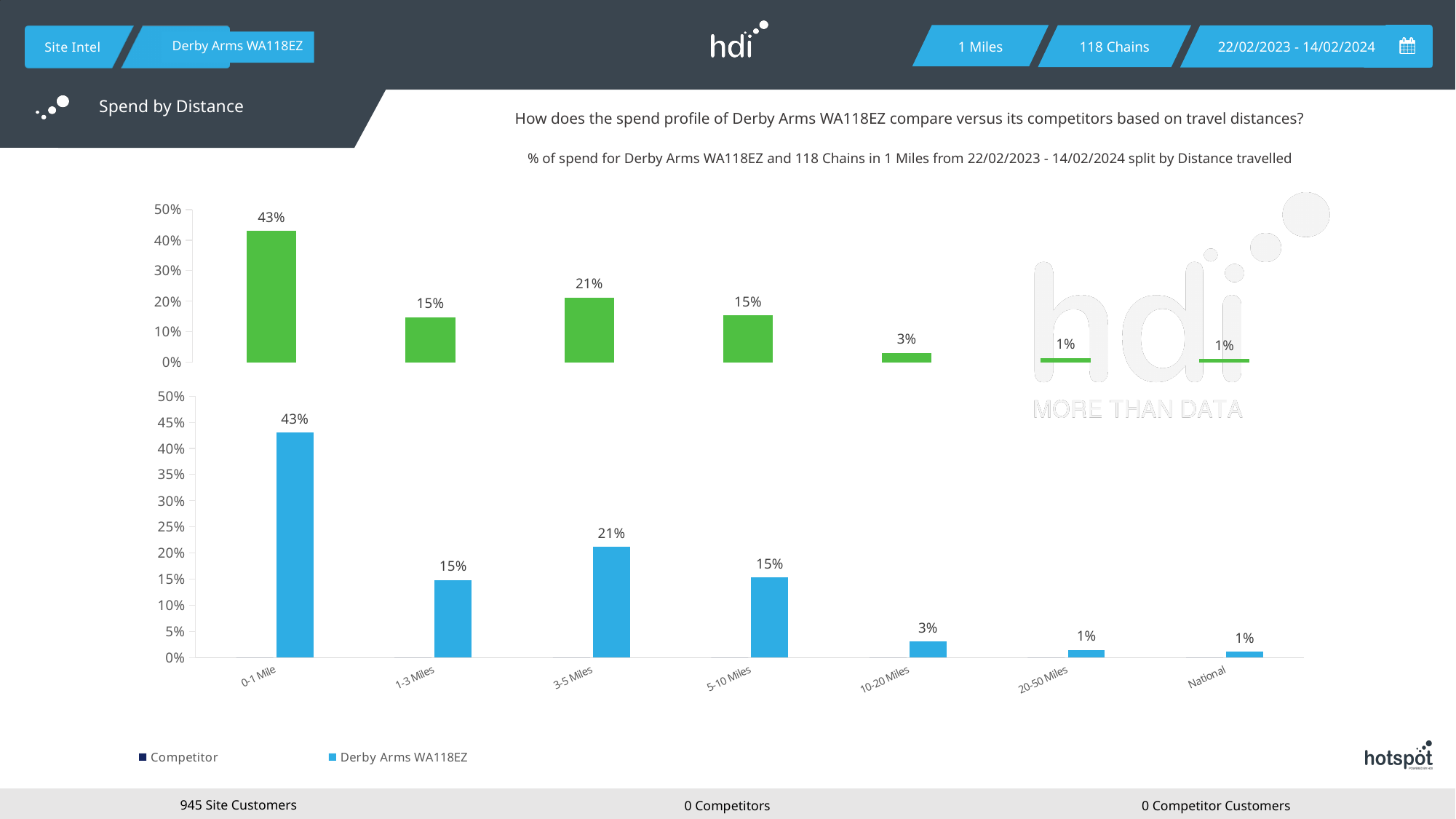
In the bottom chart, what is the value for 3-5 Miles? 21% In the bottom chart, what is the value for 0-1 Mile? 43% In the bottom chart, which category has the highest value? 0-1 Mile In the bottom chart, what is the value for 10-20 Miles? 3% In the bottom chart, what is the value for National? 1% In the bottom chart, what is the difference between the values for 0-1 Mile and 3-5 Miles? 22% What is the highest data label shown in the top chart? 43% What kind of chart is the top chart? bar chart How many series does the legend at the bottom of the slide list? 2 In the bottom chart, which is larger, the value for 1-3 Miles or the value for 3-5 Miles? 3-5 Miles In the bottom chart, is the value for 5-10 Miles greater or less than 20%? less How many categories are shown on the x axis of the bottom chart? 7